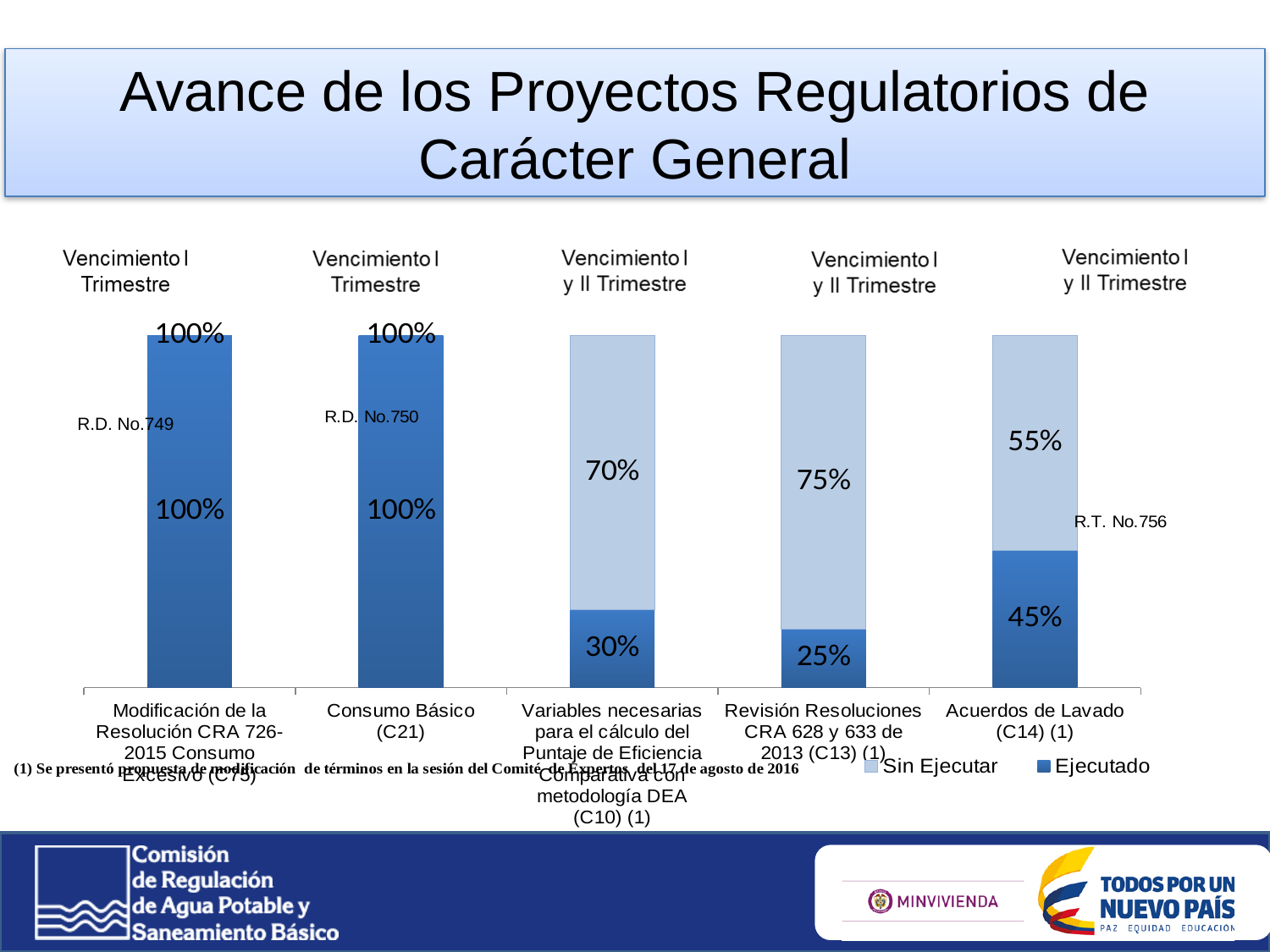
Which has a larger Ejecutado value: Acuerdos de Lavado (C14) (1) or Variables necesarias para el cálculo del Puntaje de Eficiencia Comparativa con metodología DEA (C10) (1)? Acuerdos de Lavado (C14) (1) What is the Sin Ejecutar value for Revisión Resoluciones CRA 628 y 633 de 2013 (C13) (1)? 75% What type of chart is shown on the slide? Stacked bar chart What is the Sin Ejecutar value for Variables necesarias para el cálculo del Puntaje de Eficiencia Comparativa con metodología DEA (C10) (1)? 70% What is the difference between the Ejecutado values for Acuerdos de Lavado (C14) (1) and Revisión Resoluciones CRA 628 y 633 de 2013 (C13) (1)? 20% For Revisión Resoluciones CRA 628 y 633 de 2013 (C13) (1), how much larger is the Sin Ejecutar value than the Ejecutado value? 50% How many series does the chart legend list? 2 Which category has the lowest Ejecutado value? Revisión Resoluciones CRA 628 y 633 de 2013 (C13) (1) How many categories are shown on the x axis of the chart? 5 What is the Ejecutado value for Variables necesarias para el cálculo del Puntaje de Eficiencia Comparativa con metodología DEA (C10) (1)? 30% What is the Ejecutado value for Consumo Básico (C21)? 100% What is the Ejecutado value for Acuerdos de Lavado (C14) (1)? 45%